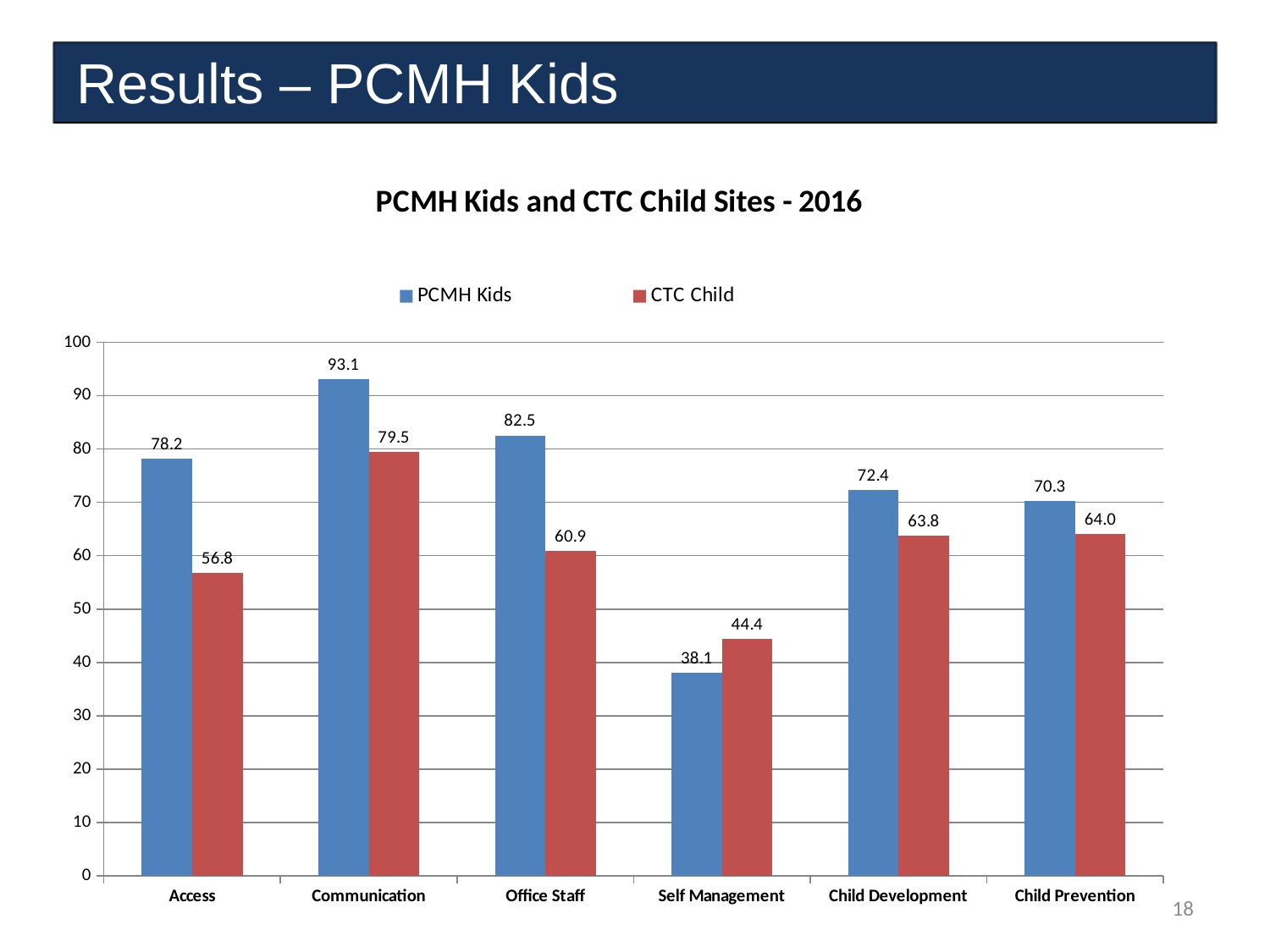
What is the difference between the PCMH Kids and CTC Child values for Office Staff? 21.6 What is the title of the chart? PCMH Kids and CTC Child Sites - 2016 How many categories are shown on the x axis? 6 Is the CTC Child value for Child Prevention greater or less than 60? greater What kind of chart is shown on the slide? Bar chart What is the CTC Child value for Self Management? 44.4 What is the PCMH Kids value for Communication? 93.1 What is the CTC Child value for Access? 56.8 Which category has the lowest CTC Child value? Self Management How many series does the legend list? 2 Which is larger for Self Management, the PCMH Kids value or the CTC Child value? CTC Child Which category has the highest PCMH Kids value? Communication